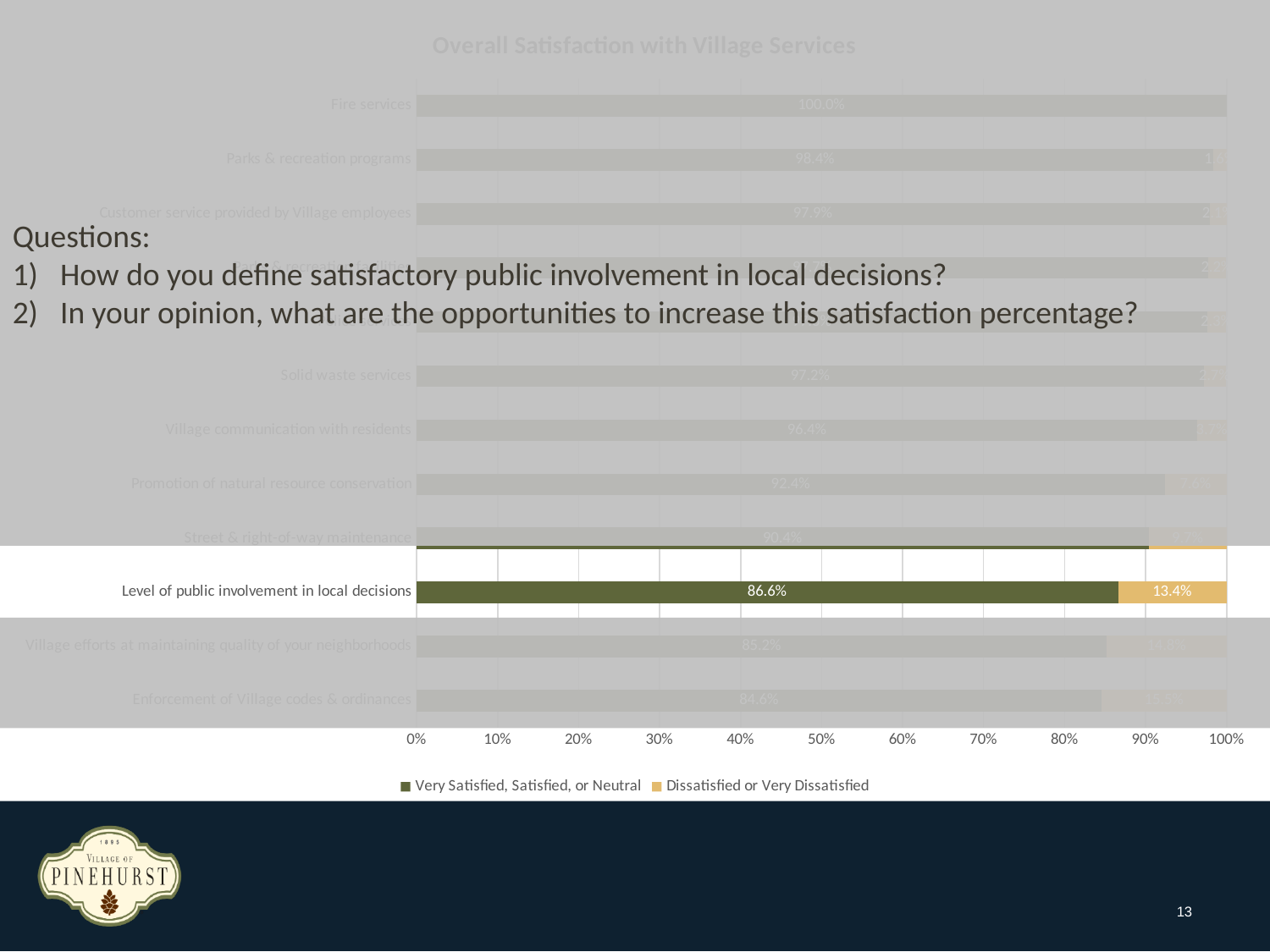
What kind of chart is shown on the slide? Stacked bar chart How many series does the legend list? 2 What are the two legend entries of the chart? Very Satisfied, Satisfied, or Neutral; Dissatisfied or Very Dissatisfied What is the difference between the 'Very Satisfied, Satisfied, or Neutral' and 'Dissatisfied or Very Dissatisfied' values for 'Level of public involvement in local decisions'? 73.2% Which category has the highest 'Very Satisfied, Satisfied, or Neutral' value? Fire services What is the 'Very Satisfied, Satisfied, or Neutral' value for 'Level of public involvement in local decisions'? 86.6% What is the 'Dissatisfied or Very Dissatisfied' value for 'Level of public involvement in local decisions'? 13.4% Which is larger for 'Level of public involvement in local decisions': the 'Very Satisfied, Satisfied, or Neutral' value or the 'Dissatisfied or Very Dissatisfied' value? Very Satisfied, Satisfied, or Neutral What is the title of the chart? Overall Satisfaction with Village Services What is the total of the stacked bar for 'Level of public involvement in local decisions'? 100% Is the 'Very Satisfied, Satisfied, or Neutral' value for 'Level of public involvement in local decisions' greater or less than 80%? greater What is the 'Very Satisfied, Satisfied, or Neutral' value for 'Fire services'? 100.0%